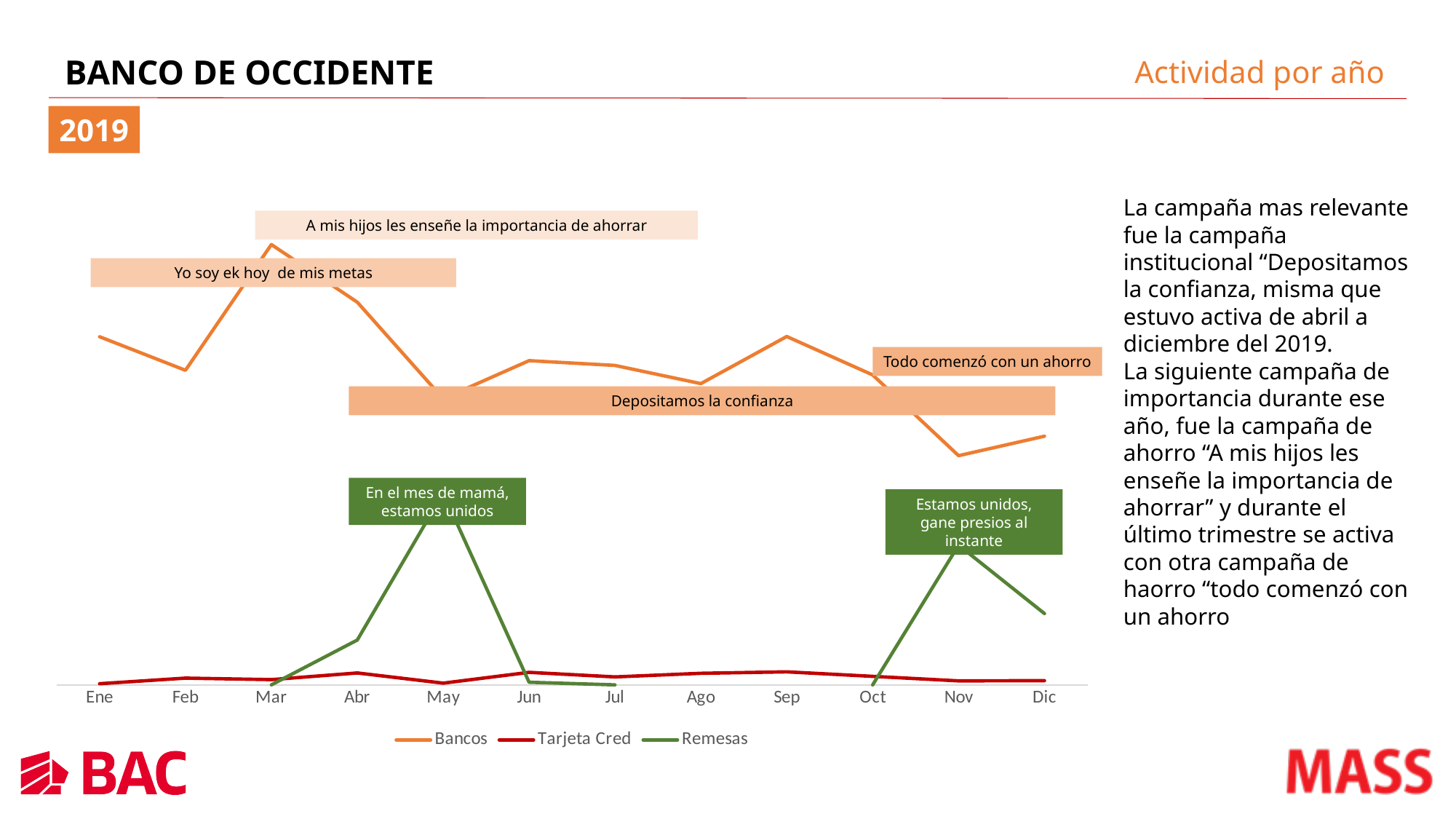
What kind of chart is shown on the slide? Line chart How many series does the chart legend list? 3 What are the three series named in the chart legend? Bancos, Tarjeta Cred, Remesas Which is larger for the Bancos series, the value in Aug or the value in Sep? Sep In which month does the Remesas series reach its highest value? May In which month does the Bancos series reach its lowest value? Nov Does the Remesas series rise or fall from Mar to May? Rise Which is larger for the Bancos series, the value in Feb or the value in Mar? Mar How many months are shown along the x axis of the chart? 12 Does the Bancos series rise or fall from Sep to Nov? Fall Which series is plotted in green? Remesas In which month does the Bancos series reach its highest value? Mar